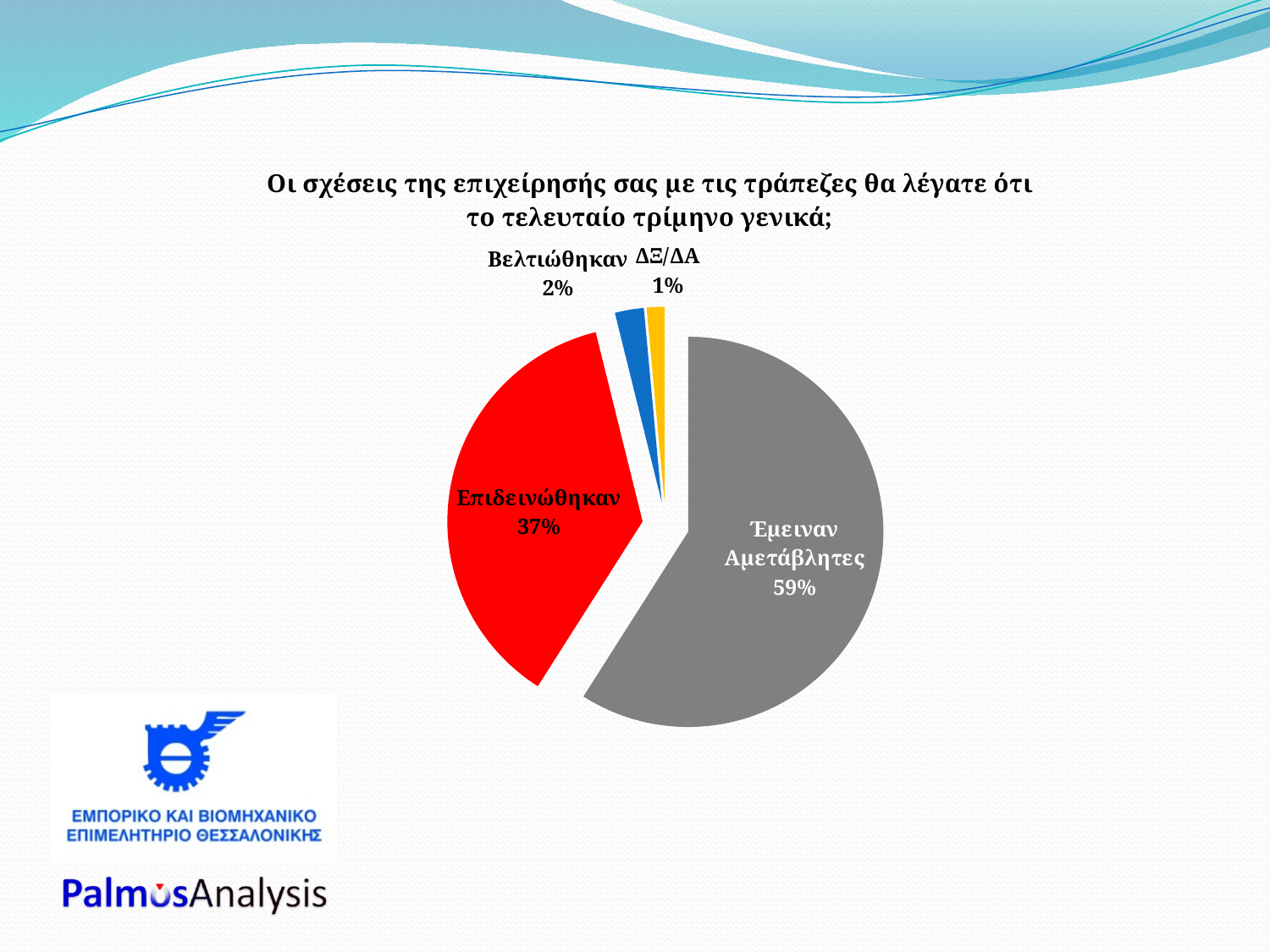
Which category has the smallest slice of the pie? ΔΞ/ΔΑ How many slices does the pie chart have? 4 What is the title of the chart? Οι σχέσεις της επιχείρησής σας με τις τράπεζες θα λέγατε ότι το τελευταίο τρίμηνο γενικά; What colour is the 'Επιδεινώθηκαν' slice? Red What is the value shown for 'Βελτιώθηκαν'? 2% Which category has the largest slice of the pie? Έμειναν Αμετάβλητες What is the value shown for 'ΔΞ/ΔΑ'? 1% What share of the pie does the 'Έμειναν Αμετάβλητες' slice represent? 59% What is the value shown for 'Επιδεινώθηκαν'? 37% What kind of chart is shown on the slide? Pie chart Which is larger, the slice for 'Επιδεινώθηκαν' or the slice for 'Βελτιώθηκαν'? Επιδεινώθηκαν What is the difference in percentage points between 'Έμειναν Αμετάβλητες' and 'Επιδεινώθηκαν'? 22 percentage points